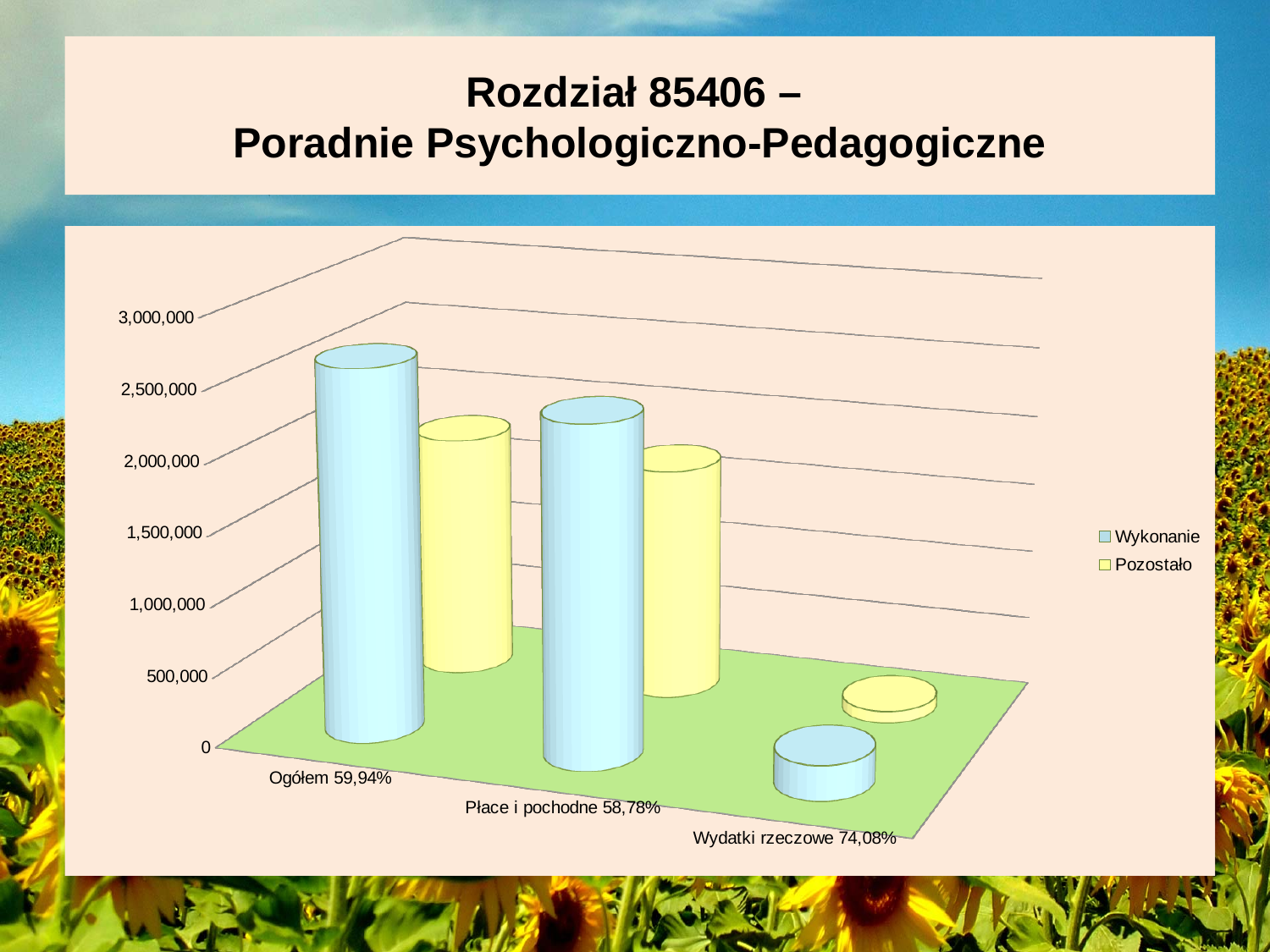
Is the Wykonanie value for Wydatki rzeczowe 74,08% greater or less than 500,000? less For Płace i pochodne 58,78%, which is larger: Wykonanie or Pozostało? Wykonanie What is the title of the slide containing the chart? Rozdział 85406 – Poradnie Psychologiczno-Pedagogiczne Which category has the lowest Pozostało value? Wydatki rzeczowe 74,08% What kind of chart is shown on the slide? Bar chart For Ogółem 59,94%, which is larger: Wykonanie or Pozostało? Wykonanie Which category has the highest Wykonanie value? Ogółem 59,94% Is the Wykonanie value for Ogółem 59,94% greater or less than 2,000,000? greater Which category has the lowest Wykonanie value? Wydatki rzeczowe 74,08% How many series does the legend list? 2 How many categories are shown on the x axis of the chart? 3 Which series is shown in blue in the chart? Wykonanie